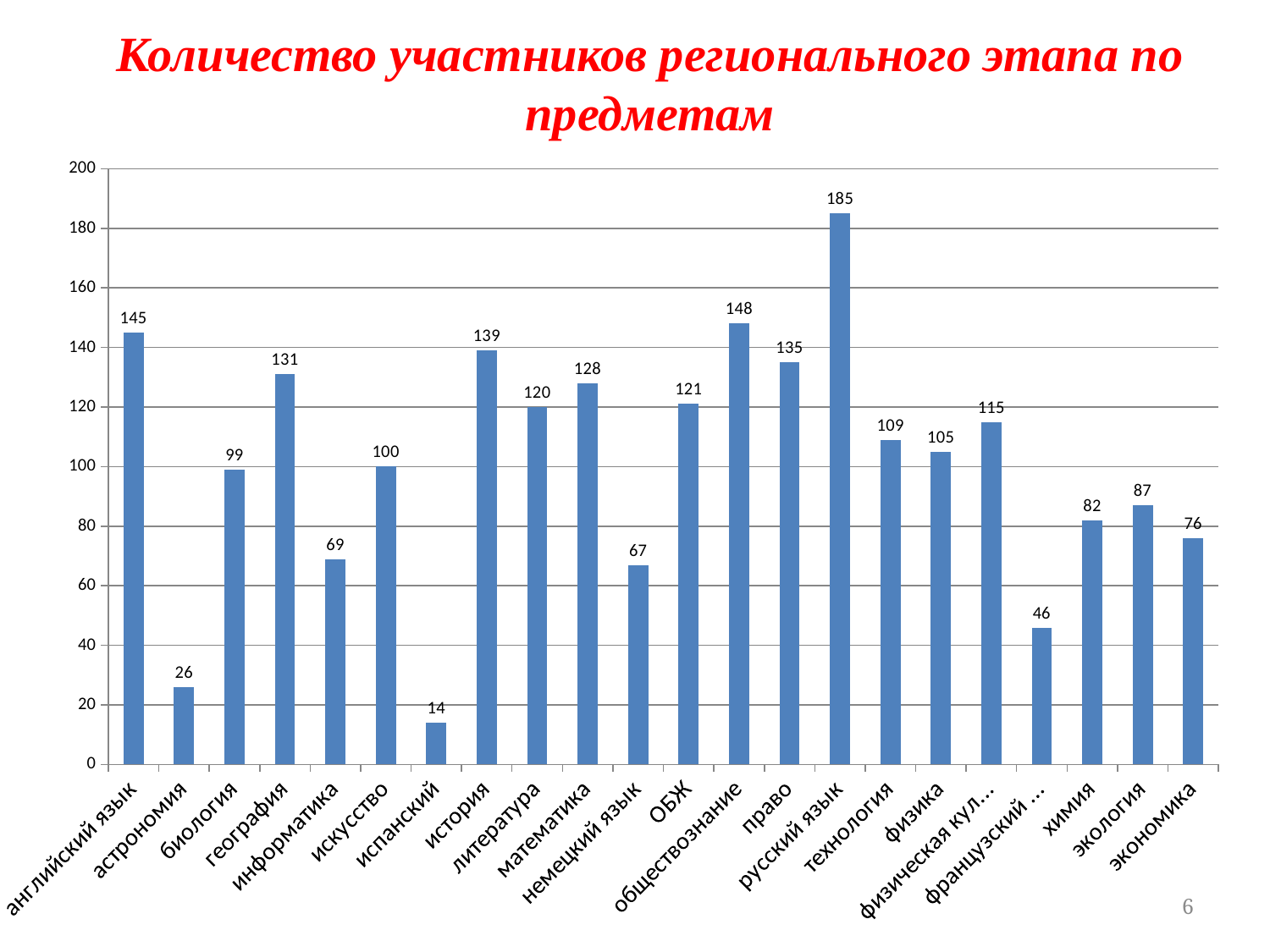
What kind of chart is shown on the slide? bar chart Which is larger, the value for химия or the value for экология? экология What is the title of the chart? Количество участников регионального этапа по предметам What is the difference between the values for английский язык and история? 6 How many subjects are shown on the x axis? 22 What is the value for русский язык? 185 Which subject has the highest number of participants? русский язык What is the value for астрономия? 26 What is the value for обществознание? 148 Which subject has the lowest number of participants? испанский Which is larger, the value for география or the value for математика? география What is the difference between the values for русский язык and право? 50